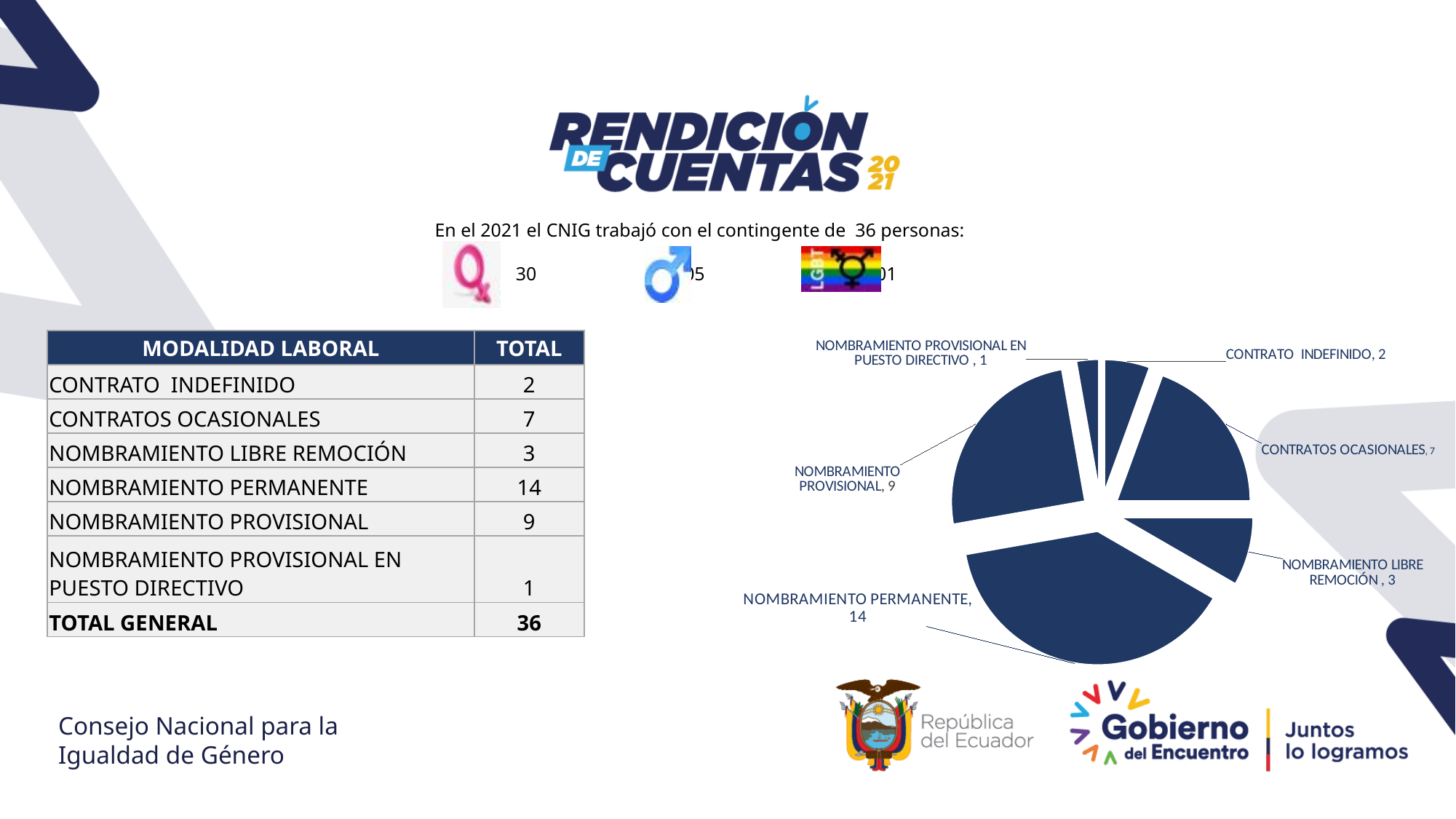
What is the value for CONTRATOS OCASIONALES in the pie chart? 7 What is the value for NOMBRAMIENTO PROVISIONAL in the pie chart? 9 What is the total of all the slices in the pie chart? 36 How many slices does the pie chart have? 6 What is the value for NOMBRAMIENTO PERMANENTE in the pie chart? 14 What kind of chart is shown on the slide? pie chart What is the value for NOMBRAMIENTO LIBRE REMOCIÓN in the pie chart? 3 What share of the pie does NOMBRAMIENTO PROVISIONAL represent? 25% What is the difference between the values for NOMBRAMIENTO PERMANENTE and NOMBRAMIENTO PROVISIONAL in the pie chart? 5 Which category has the smallest slice in the pie chart? NOMBRAMIENTO PROVISIONAL EN PUESTO DIRECTIVO Which is larger in the pie chart, CONTRATOS OCASIONALES or NOMBRAMIENTO LIBRE REMOCIÓN? CONTRATOS OCASIONALES Which category has the largest slice in the pie chart? NOMBRAMIENTO PERMANENTE